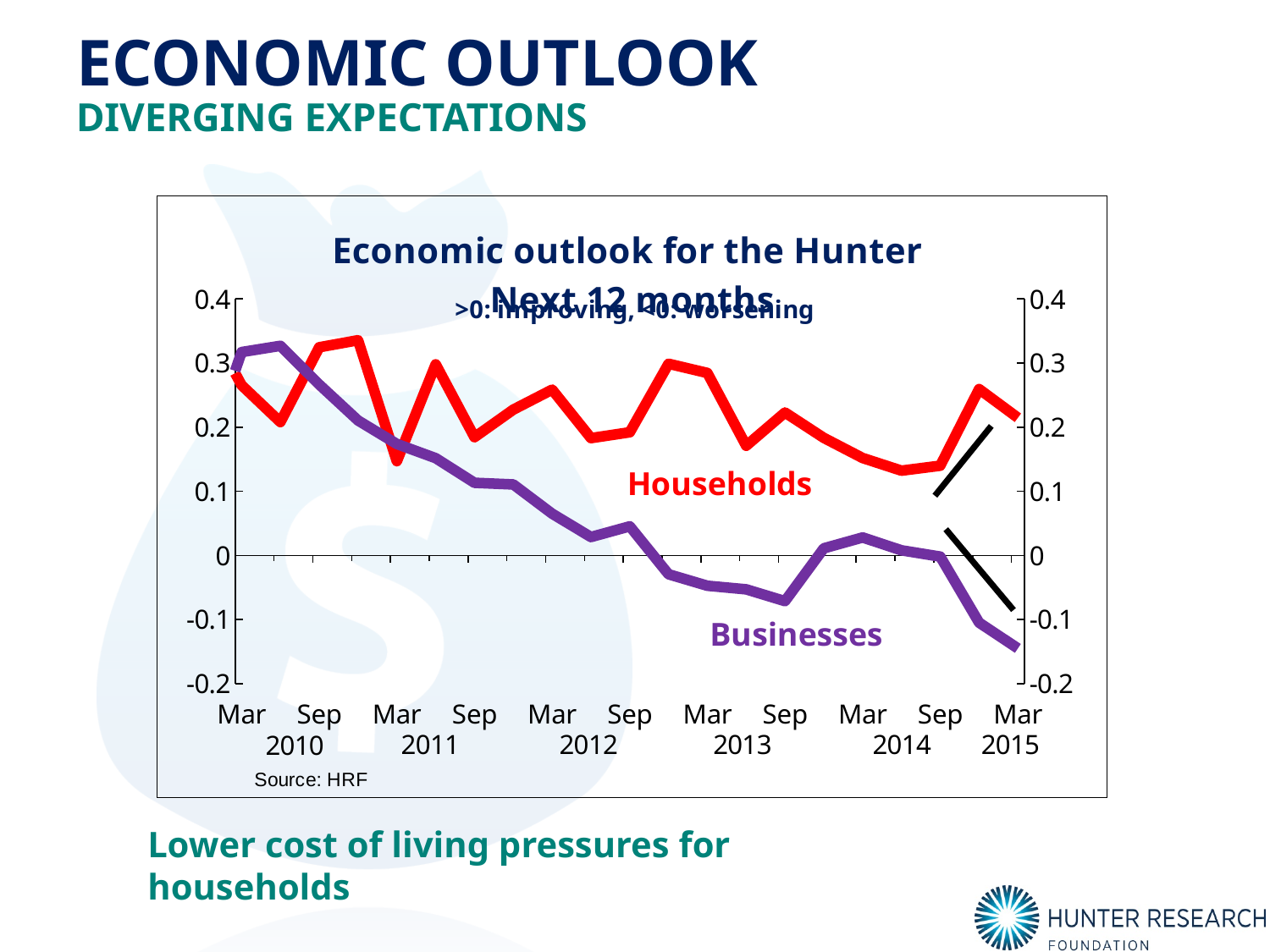
What kind of chart is shown on the slide? line chart At Mar 2015, which series has the higher value, Households or Businesses? Households Is the value for Households at Mar 2015 greater or less than 0.1? greater Is the value for Businesses at Mar 2015 greater or less than 0? less Is the value for Businesses at Mar 2010 greater or less than 0.2? greater How many series are plotted on the chart? 2 Does the Businesses line generally rise or fall from Mar 2010 to Mar 2015? fall What source is cited below the chart? HRF How many date labels are shown along the x axis? 11 At which x-axis date does the Businesses line reach its lowest value? Mar 2015 What is the title of the chart? Economic outlook for the Hunter Next 12 months